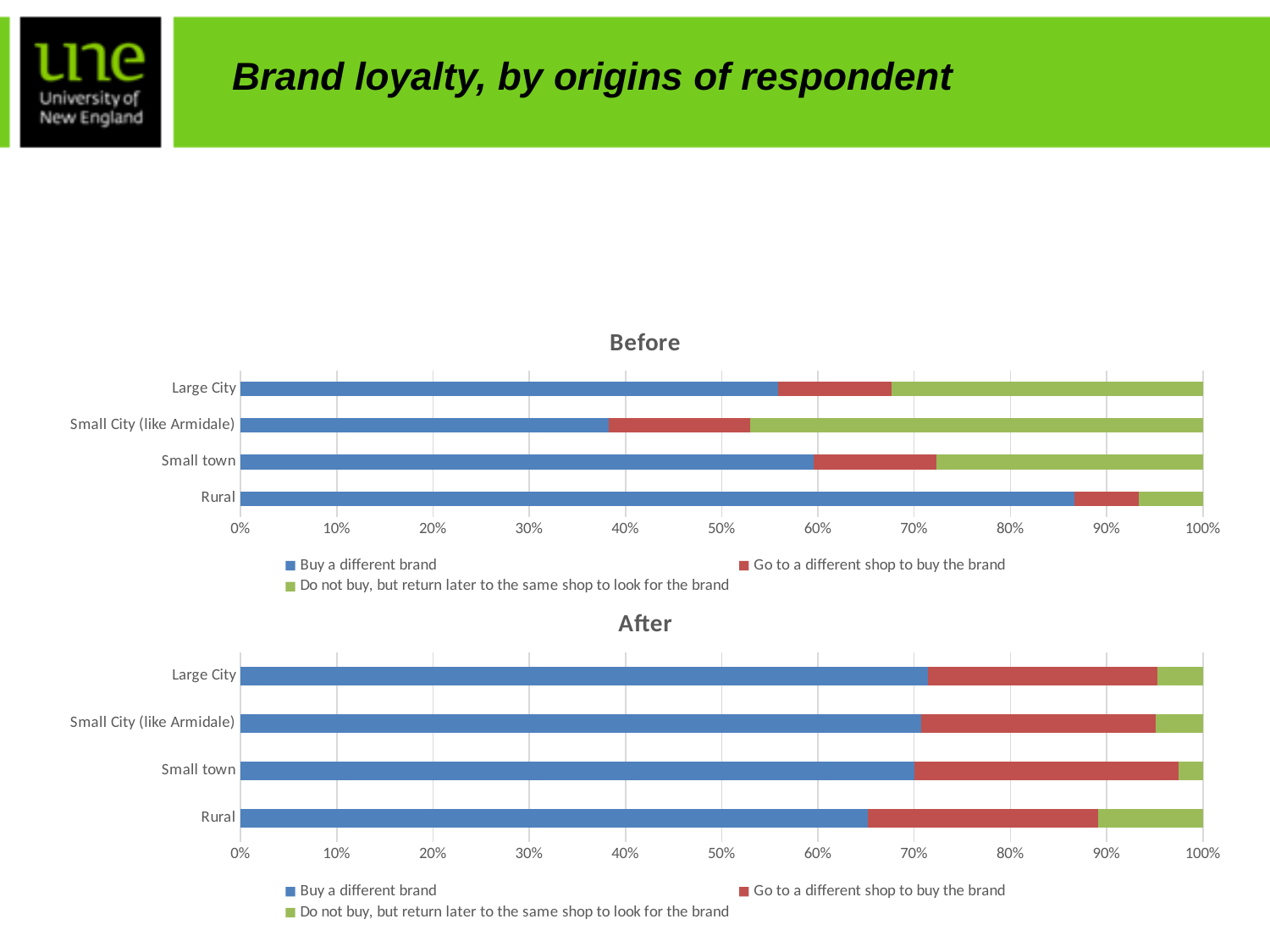
How many categories are shown on the "After" chart? 4 In the "After" chart, is the value for "Buy a different brand" for Rural greater or less than 60%? greater What kind of chart is the "Before" chart? Stacked bar chart In the "Before" chart, is the value for "Buy a different brand" for Small City (like Armidale) greater or less than 50%? less In the "Before" chart, which category has the lowest value for "Buy a different brand"? Small City (like Armidale) How many series does the legend of the "Before" chart list? 3 What is the total of each stacked bar in the "After" chart? 100% In the "Before" chart, which category has the highest value for "Buy a different brand"? Rural In the "Before" chart, which is larger for "Buy a different brand": Large City or Small City (like Armidale)? Large City In the "After" chart, which category has the lowest value for "Buy a different brand"? Rural In the "Before" chart, is the value for "Buy a different brand" for Rural greater or less than 80%? greater What colour represents "Go to a different shop to buy the brand" in the charts? Red